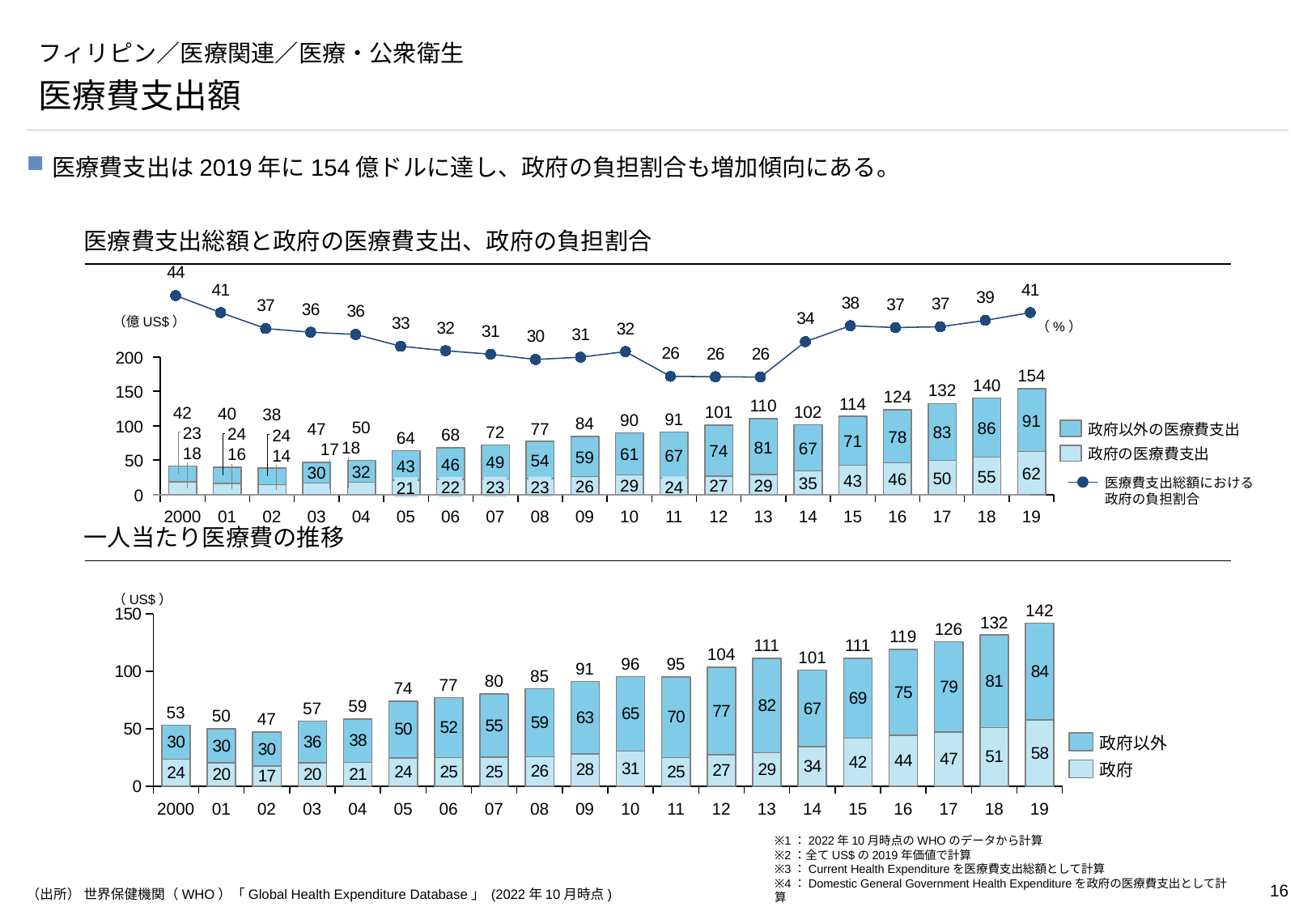
In the bottom chart, which year has the lowest total per-capita health expenditure? 2002 How many years are shown on the x axis of the bottom chart? 20 In the bottom chart, what is the 政府 value for 2018? 51 What kind of chart is the bottom chart (一人当たり医療費の推移)? Stacked bar chart In the top chart, what is the government's share (政府の負担割合) in 2000? 44 In the bottom chart, which year has the larger total per-capita expenditure, 2013 or 2014? 2013 How many series does the legend of the top chart list? 3 In the top chart (医療費支出総額と政府の医療費支出、政府の負担割合), what is the total health expenditure for 2019? 154 In the top chart, what is the difference between 政府以外の医療費支出 and 政府の医療費支出 in 2019? 29 In the top chart, what is the value of 政府の医療費支出 for 2015? 43 In the top chart, in which year is the government's share (政府の負担割合) line highest? 2000 In the bottom chart (一人当たり医療費の推移), what is the total per-capita health expenditure for 2019? 142